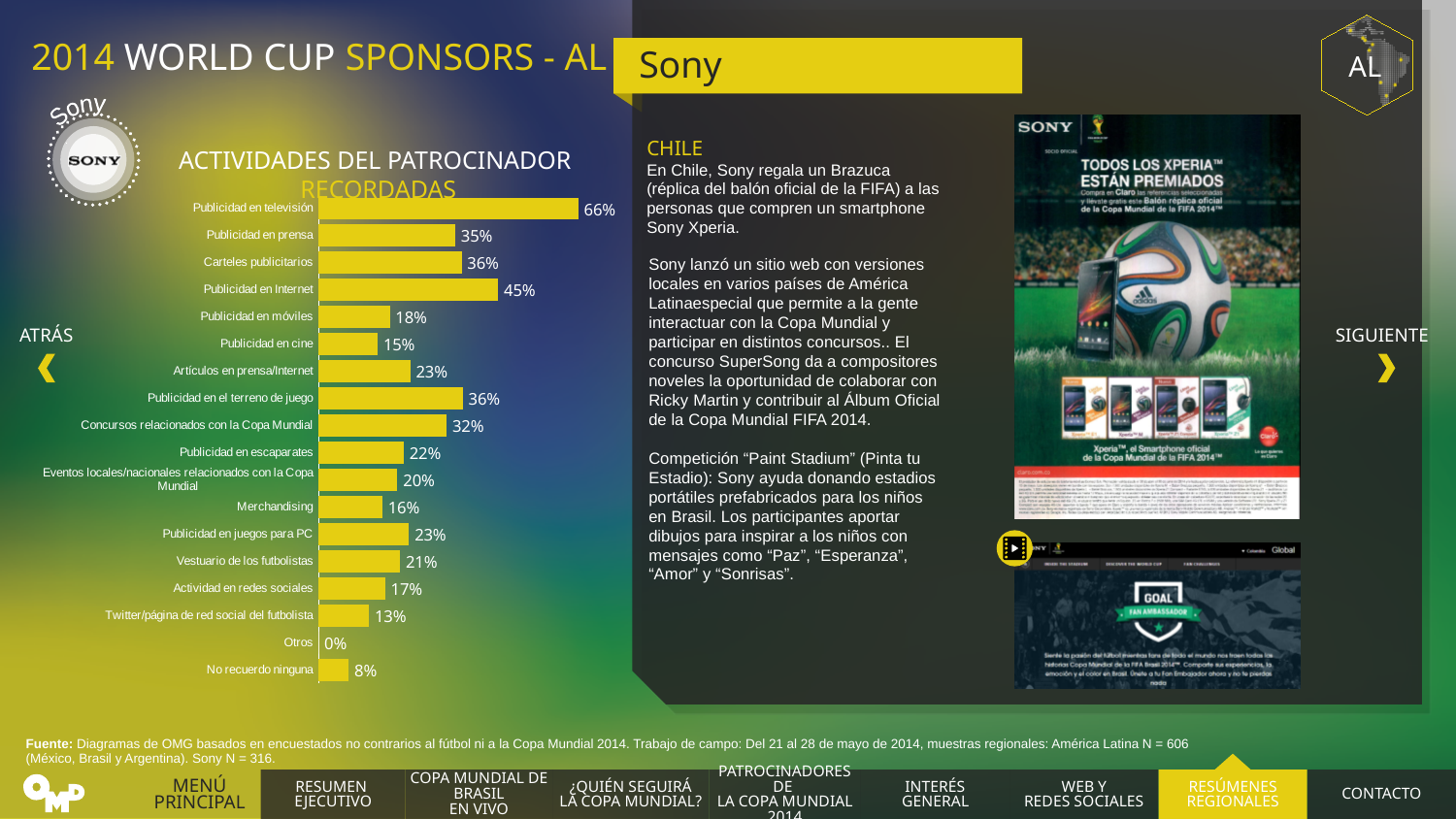
What is the value for Concursos relacionados con la Copa Mundial? 32% Which category has the lowest value? Otros What is the difference between Publicidad en el terreno de juego and Twitter/página de red social del futbolista? 23% What kind of chart is shown on the slide? Bar chart What is the difference between Publicidad en televisión and Publicidad en Internet? 21% Which category has the highest value? Publicidad en televisión What is the value for Publicidad en Internet? 45% What is the value for No recuerdo ninguna? 8% What is the value for Publicidad en televisión? 66% What is the title of the chart? ACTIVIDADES DEL PATROCINADOR RECORDADAS Which is larger, Publicidad en móviles or Publicidad en cine? Publicidad en móviles How many categories are shown in the chart? 18